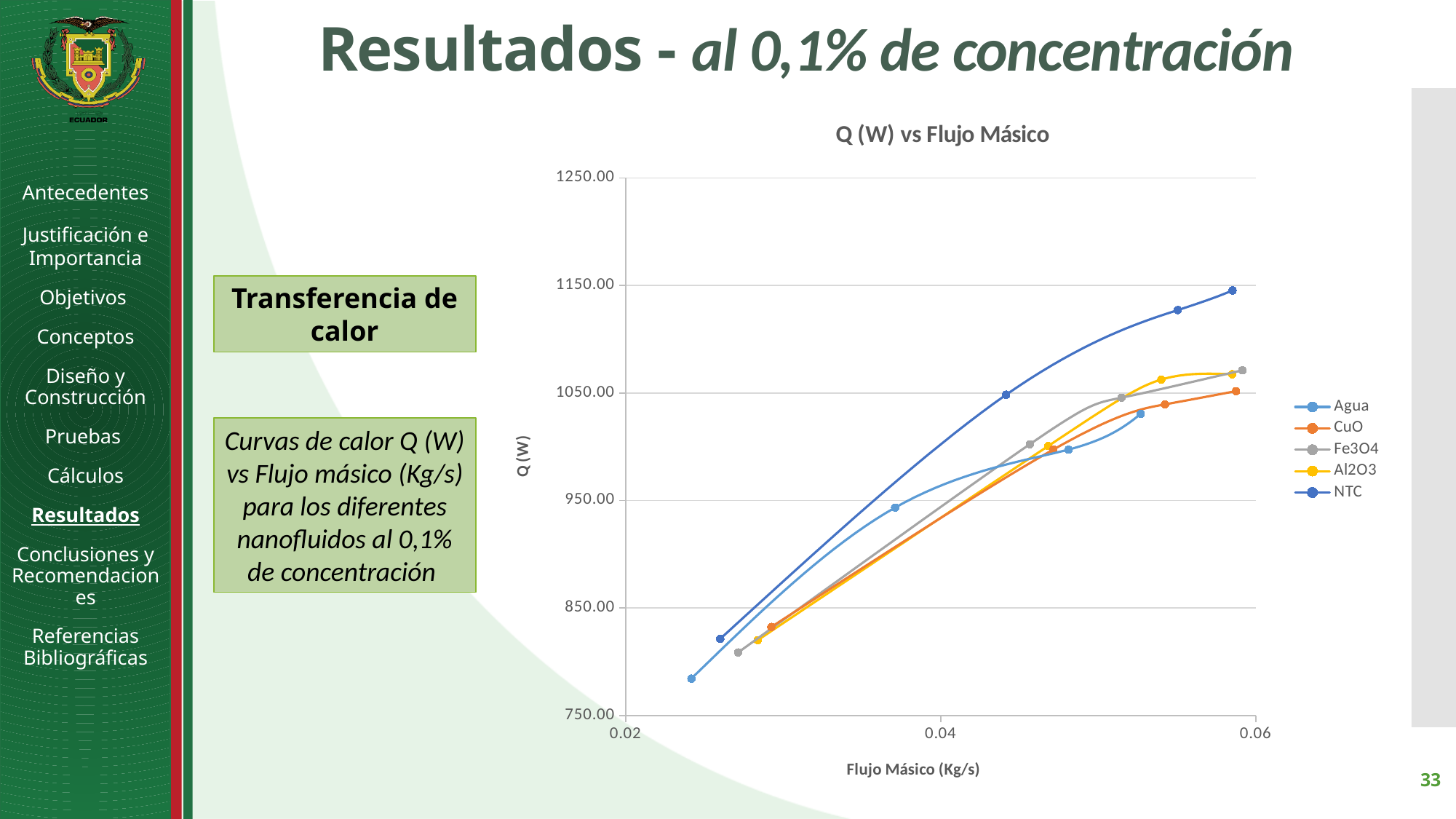
What is the title of the chart? Q (W) vs Flujo Másico At the highest mass flow, which series has the larger Q (W) value, NTC or CuO? NTC Which series has the lowest Q (W) value at its first (lowest mass flow) point? Agua What is the label of the x axis of the chart? Flujo Másico (Kg/s) How many data points are plotted for the NTC series? 4 Is the highest Q (W) value of the NTC series greater or less than 1050? greater What kind of chart is shown on the slide? line chart How many series does the legend of the chart list? 5 Do the Q (W) values rise or fall as the mass flow increases along the x axis? rise Is the Q (W) value of the first Agua point greater or less than 850? less Is the Q (W) value of the last Fe3O4 point greater or less than 1050? greater Which series reaches the highest Q (W) value at the highest mass flow? NTC